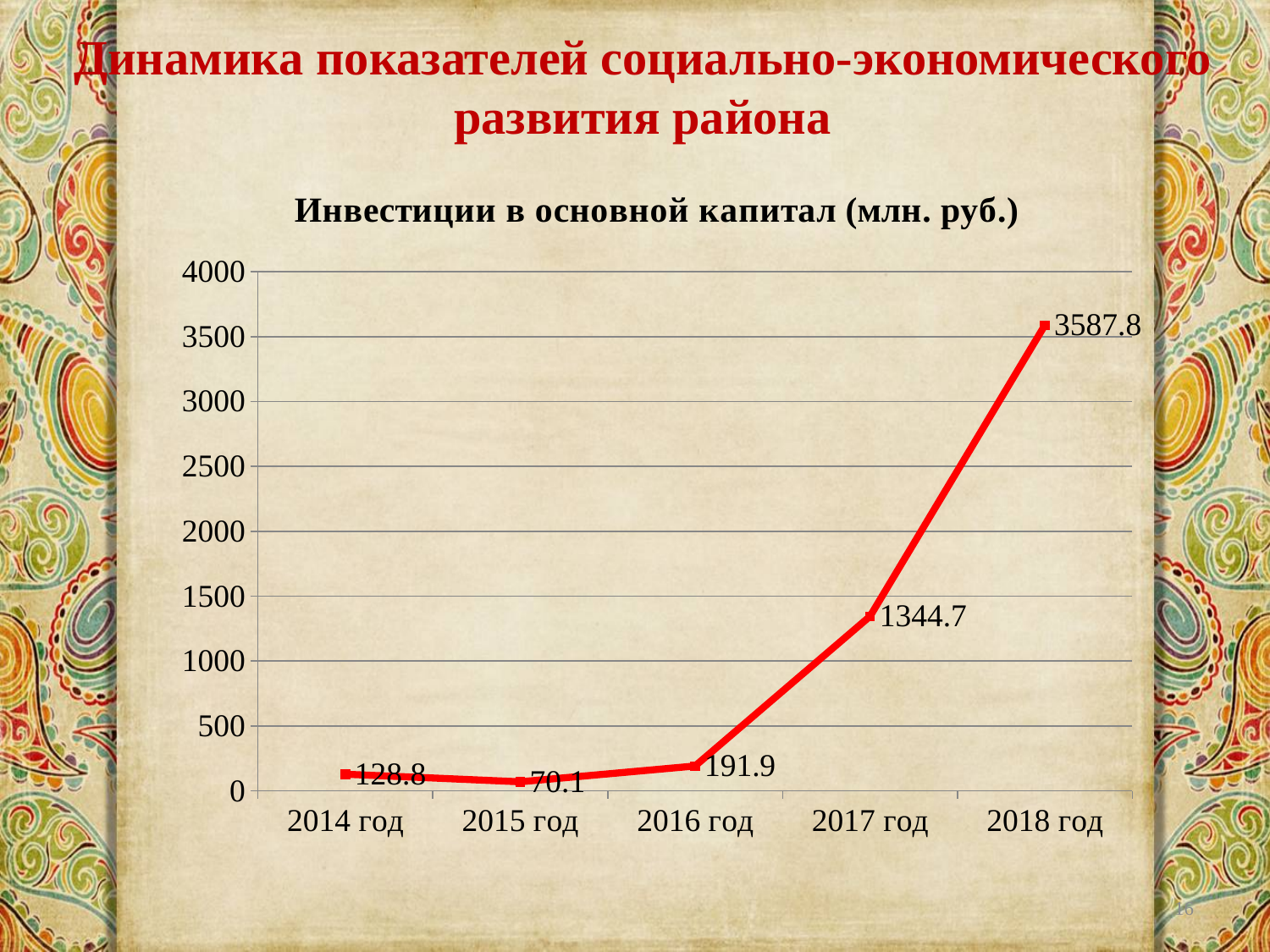
What is the value for 2015 год? 70.1 What is the value for 2018 год? 3587.8 What is the value for 2017 год? 1344.7 Which is larger, the value for 2016 год or the value for 2014 год? 2016 год What is the value for 2014 год? 128.8 What is the title of the chart? Инвестиции в основной капитал (млн. руб.) Is the value for 2017 год greater or less than 1000? greater Which year has the highest value? 2018 год What is the difference between the values for 2018 год and 2017 год? 2243.1 Which year has the lowest value? 2015 год How many years are plotted on the chart? 5 What kind of chart is shown? line chart